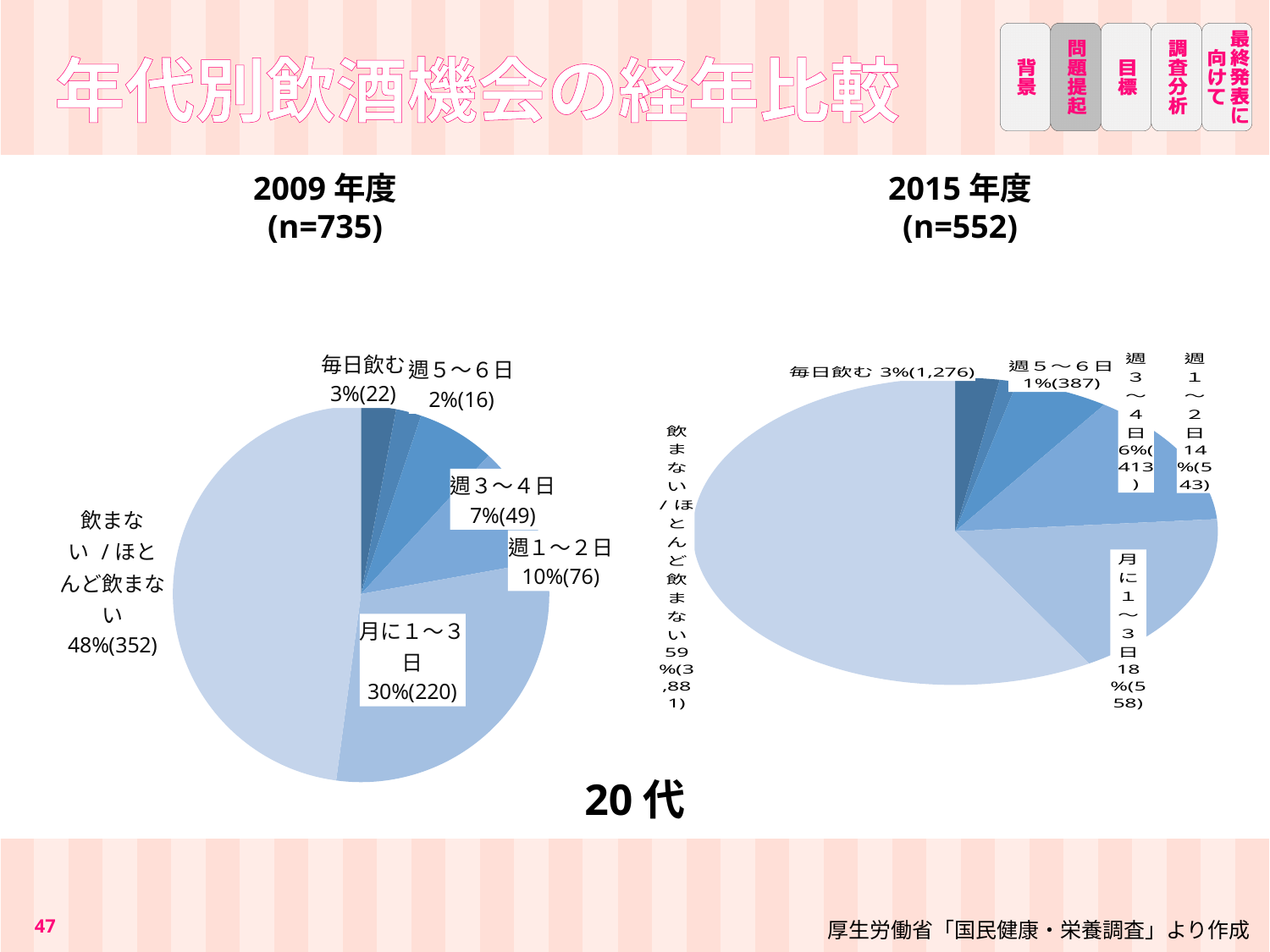
In the 2009年度 (n=735) pie chart, which category has the smallest share? 週5～6日 What type of chart is used for the 2009年度 data on the slide? pie chart In the 2015年度 (n=552) pie chart, which category has the largest share? 飲まない/ほとんど飲まない In the 2015年度 (n=552) pie chart, which is larger: the share for 月に1～3日 or the share for 週3～4日? 月に1～3日 In the 2015年度 (n=552) pie chart, what percentage is shown for 週1～2日? 14% In the 2015年度 (n=552) pie chart, what is the value shown for 飲まない/ほとんど飲まない? 59%(3,881) In the 2009年度 (n=735) pie chart, what is the value shown for 月に1～3日? 30%(220) In the 2009年度 (n=735) pie chart, what is the value shown for 飲まない/ほとんど飲まない? 48%(352) In the 2015年度 (n=552) pie chart, what is the value shown for 毎日飲む? 3%(1,276) In the 2009年度 (n=735) pie chart, what is the difference in percentage points between 月に1～3日 and 週1～2日? 20 In the 2009年度 (n=735) pie chart, what percentage is shown for 週1～2日? 10% How many categories (slices) does the 2009年度 (n=735) pie chart have? 6